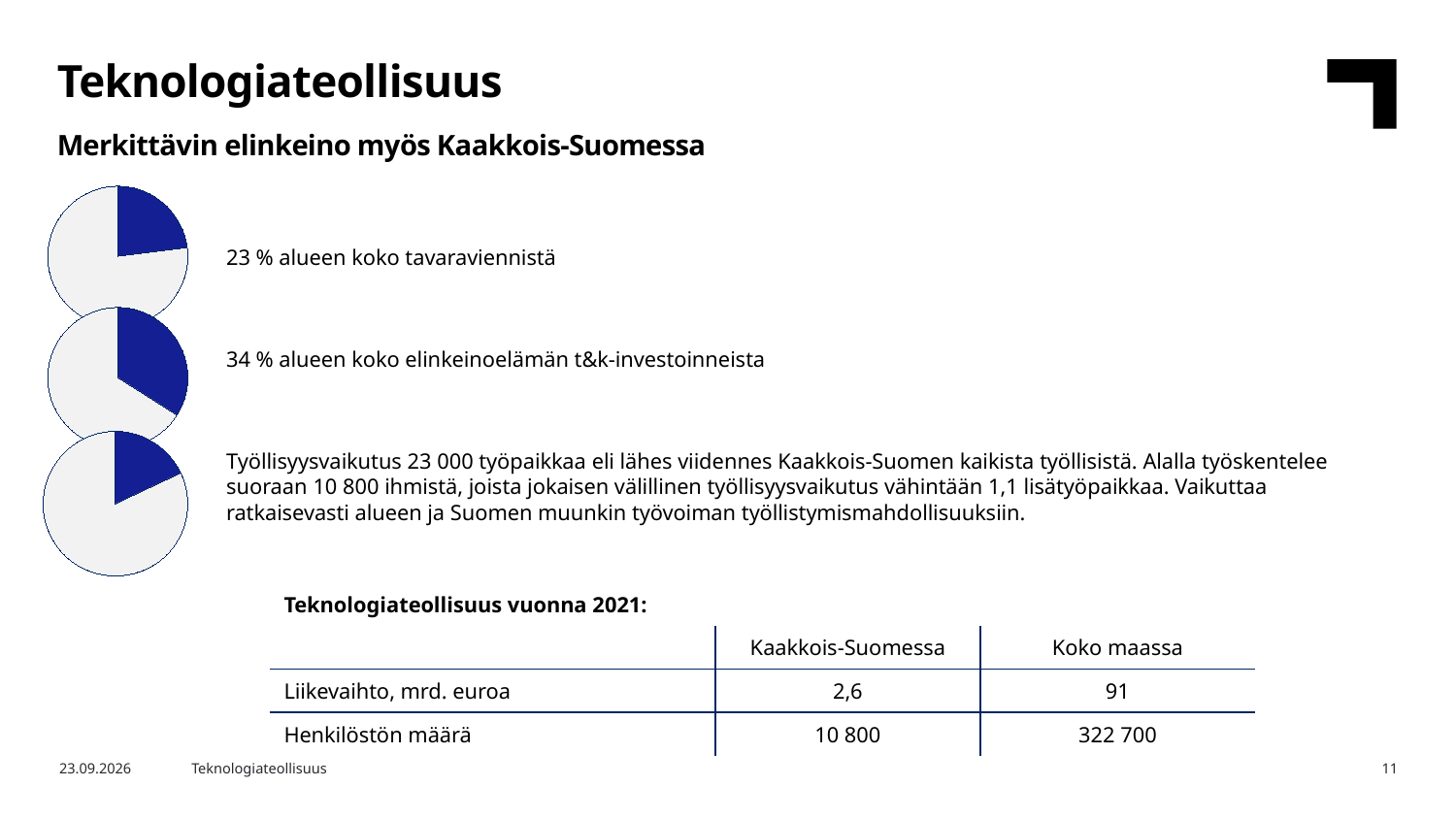
What is the difference in percentage points between the highlighted shares of the middle pie chart (34 %) and the top pie chart (23 %)? 11 percentage points In the top pie chart, what share of the region's total goods exports (tavaravienti) does the highlighted slice represent? 23 % How many pie charts are on the slide? 3 How many slices does each pie chart have? 2 Which pie chart has the larger highlighted slice, the middle one (t&k-investoinnit) or the bottom one (työllisyysvaikutus)? The middle one (t&k-investoinnit) What colour is the highlighted slice in each pie chart? Dark blue What kind of charts are shown on the left side of the slide? Pie charts Which pie chart has the larger highlighted slice, the top one (tavaravienti) or the middle one (t&k-investoinnit)? The middle one (t&k-investoinnit) Which of the three pie charts has the largest highlighted slice? The middle one (34 % of t&k-investoinnit) In the middle pie chart, what share of the region's business R&D investments (t&k-investoinnit) does the highlighted slice represent? 34 %